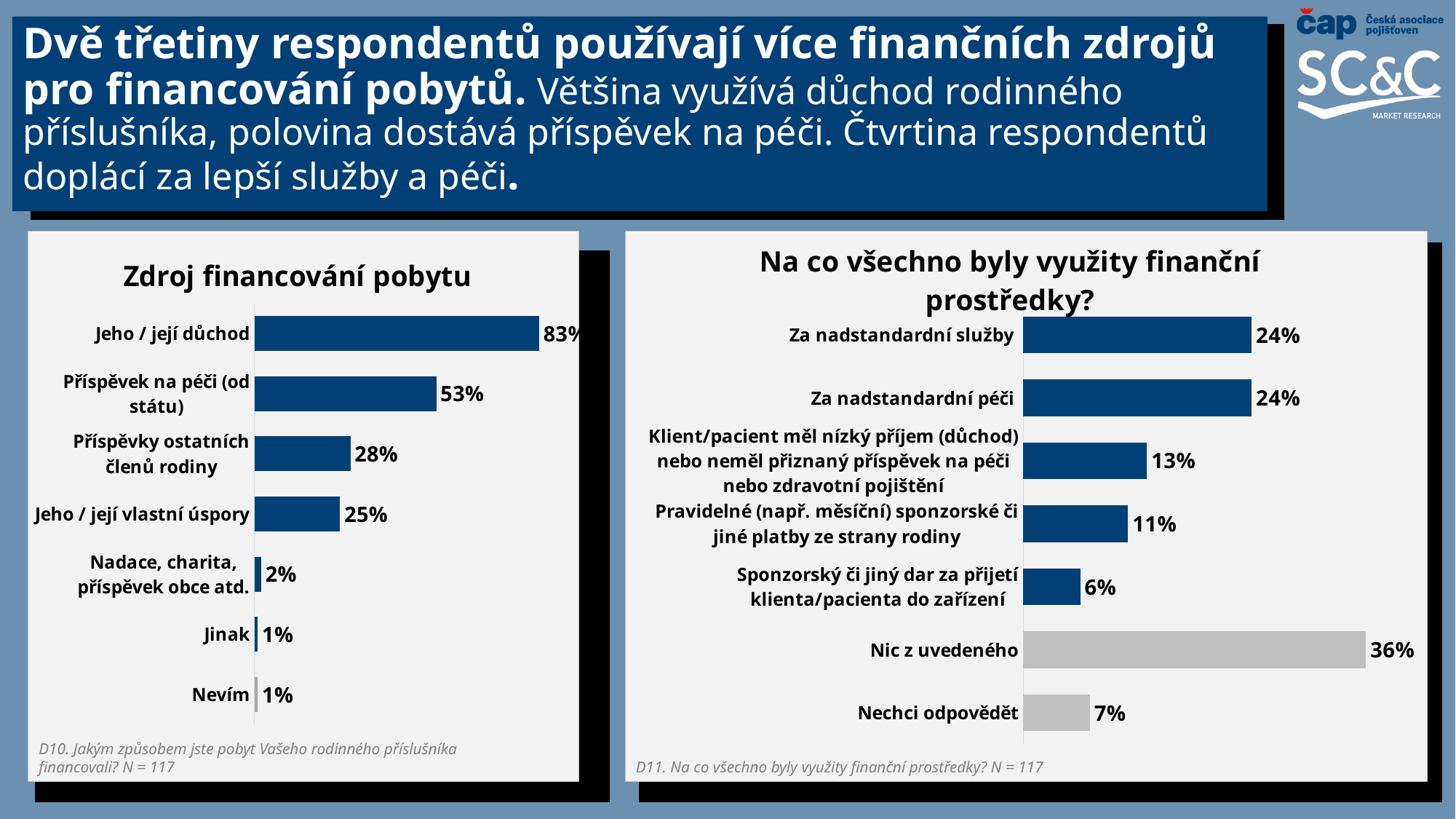
In the chart 'Zdroj financování pobytu', how many categories are shown? 7 In the chart 'Na co všechno byly využity finanční prostředky?', how many categories are shown? 7 In the chart 'Zdroj financování pobytu', what is the value for 'Příspěvek na péči (od státu)'? 53% In the chart 'Na co všechno byly využity finanční prostředky?', what is the value for 'Nic z uvedeného'? 36% What type of chart is 'Zdroj financování pobytu'? Bar chart In the chart 'Zdroj financování pobytu', which category has the highest value? Jeho / její důchod In the chart 'Na co všechno byly využity finanční prostředky?', which is larger: 'Pravidelné (např. měsíční) sponzorské či jiné platby ze strany rodiny' or 'Sponzorský či jiný dar za přijetí klienta/pacienta do zařízení'? Pravidelné (např. měsíční) sponzorské či jiné platby ze strany rodiny In the chart 'Na co všechno byly využity finanční prostředky?', what is the value for 'Za nadstandardní péči'? 24% In the chart 'Zdroj financování pobytu', what is the difference between 'Příspěvky ostatních členů rodiny' and 'Jeho / její vlastní úspory'? 3% In the chart 'Zdroj financování pobytu', what is the value for 'Nadace, charita, příspěvek obce atd.'? 2% In the chart 'Zdroj financování pobytu', what is the value for 'Jeho / její důchod'? 83% In the chart 'Na co všechno byly využity finanční prostředky?', which category has the highest value? Nic z uvedeného